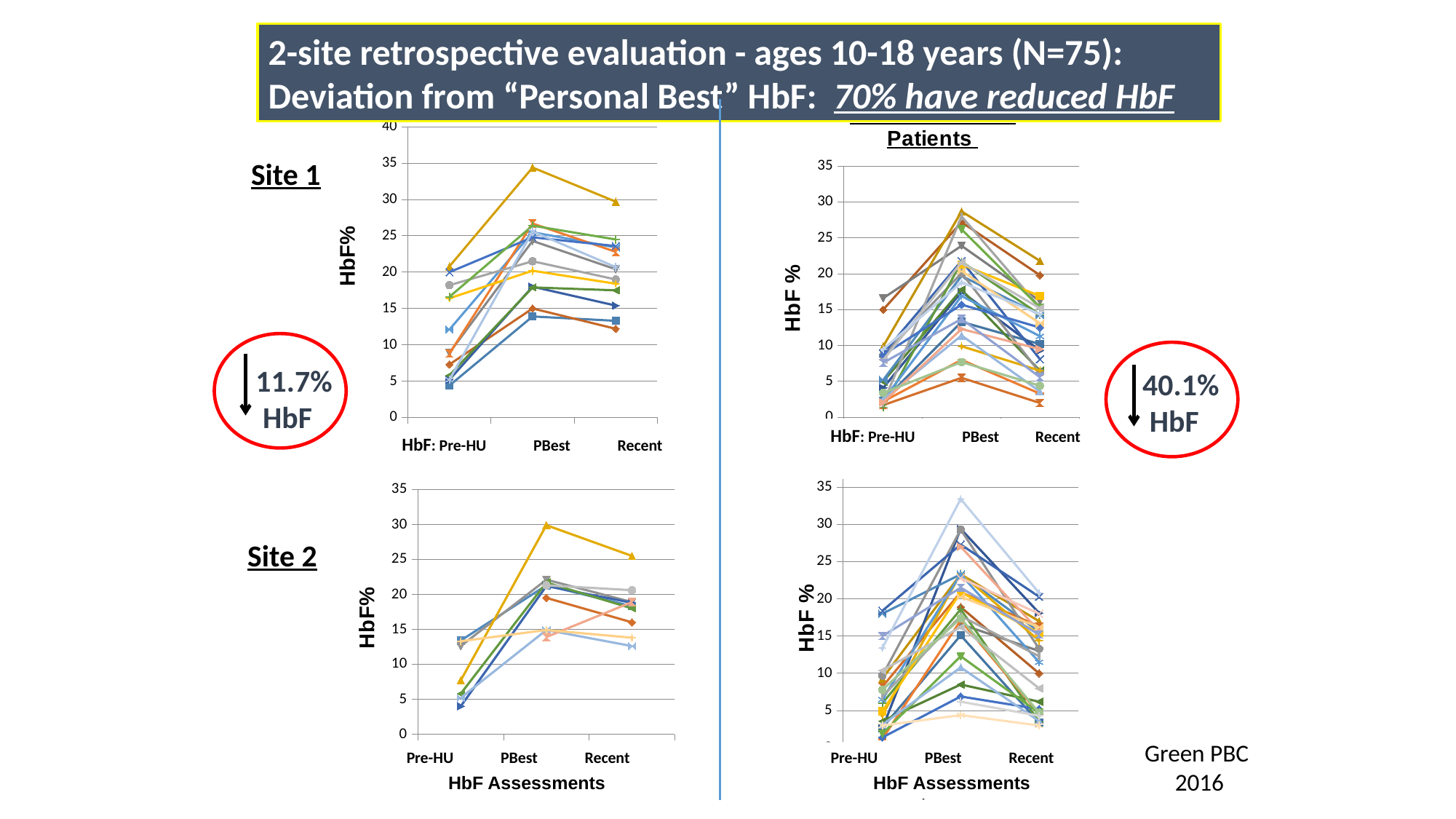
What is the y-axis label of the top-left chart (Site 1, top)? HbF% In the top-right chart, is the highest value at PBest greater or less than 25? greater In the top-left chart (Site 1, top), do the lines generally rise or fall from Pre-HU to PBest? rise In the bottom-left chart (Site 2), is the highest value at PBest greater or less than 25? greater What kind of chart is the top-left chart (Site 1, top)? Line chart In the top-left chart (Site 1, top), is the highest value at PBest greater or less than 30? greater How many x-axis categories does the top-right chart show? 3 How many x-axis categories does the bottom-left chart (Site 2) show? 3 What is the x-axis title of the bottom-right chart? HbF Assessments In the bottom-right chart, do the lines generally rise or fall from PBest to Recent? fall